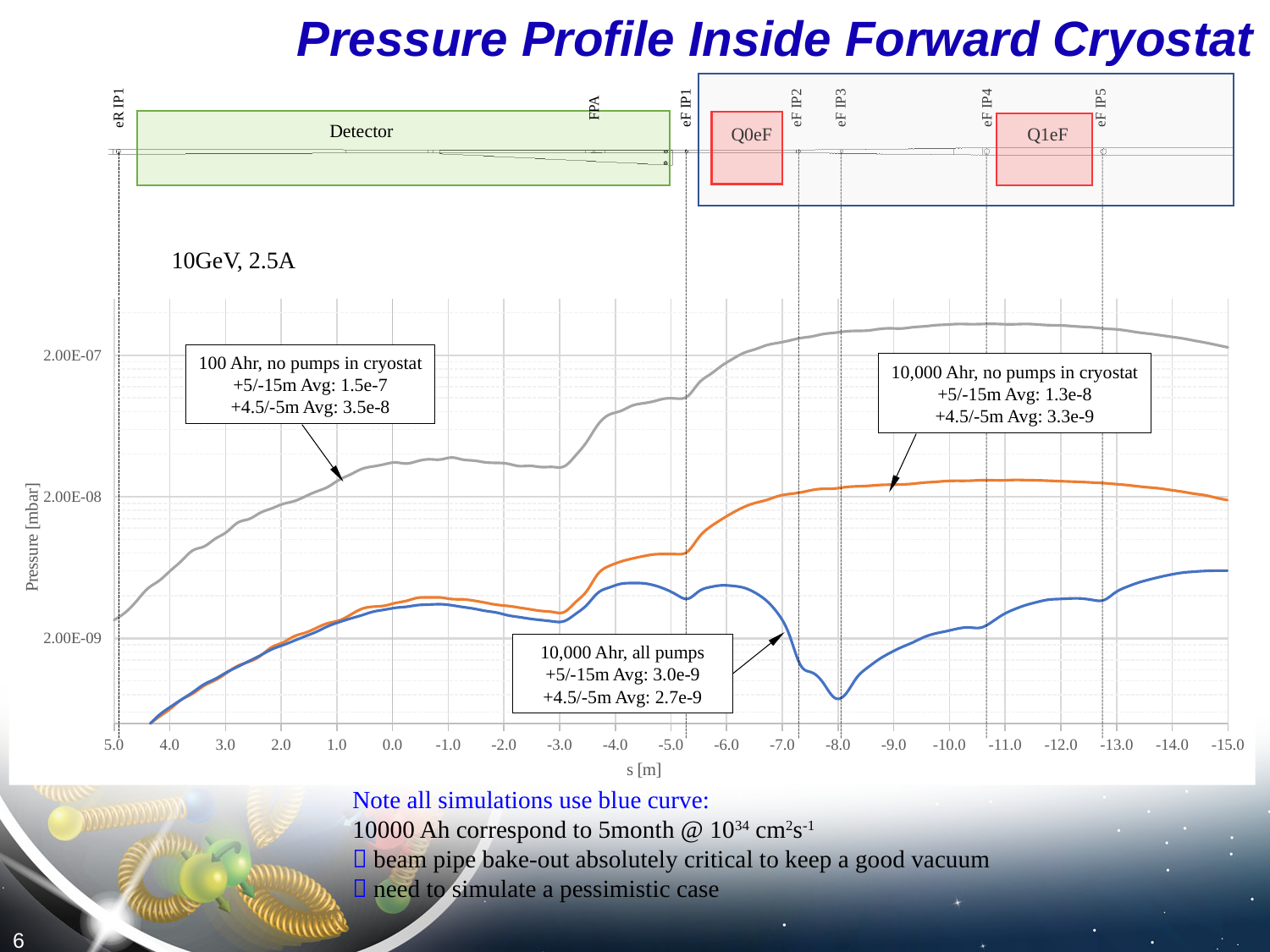
How many pressure curves are plotted on the chart? 3 Does the gray (100 Ahr, no pumps) curve rise or fall as s goes from 5.0 m to -10.0 m? rise Is the value of the blue (10,000 Ahr, all pumps) curve at s = -8.0 m greater or less than 2.00E-09? less Is the +5/-15m average of the '100 Ahr, no pumps in cryostat' curve larger or smaller than that of the '10,000 Ahr, no pumps in cryostat' curve? larger What is the +4.5/-5m average pressure for the '10,000 Ahr, no pumps in cryostat' curve? 3.3e-9 What is the label of the y axis of the chart? Pressure [mbar] What is the +5/-15m average pressure for the '100 Ahr, no pumps in cryostat' curve? 1.5e-7 Which curve has the highest +5/-15m average pressure? 100 Ahr, no pumps in cryostat What is the +5/-15m average pressure for the '10,000 Ahr, all pumps' curve? 3.0e-9 Which curve has the lowest +4.5/-5m average pressure? 10,000 Ahr, all pumps Is the value of the gray (100 Ahr, no pumps) curve at s = -10.0 m greater or less than 2.00E-07? greater What kind of chart is shown on the slide? line chart